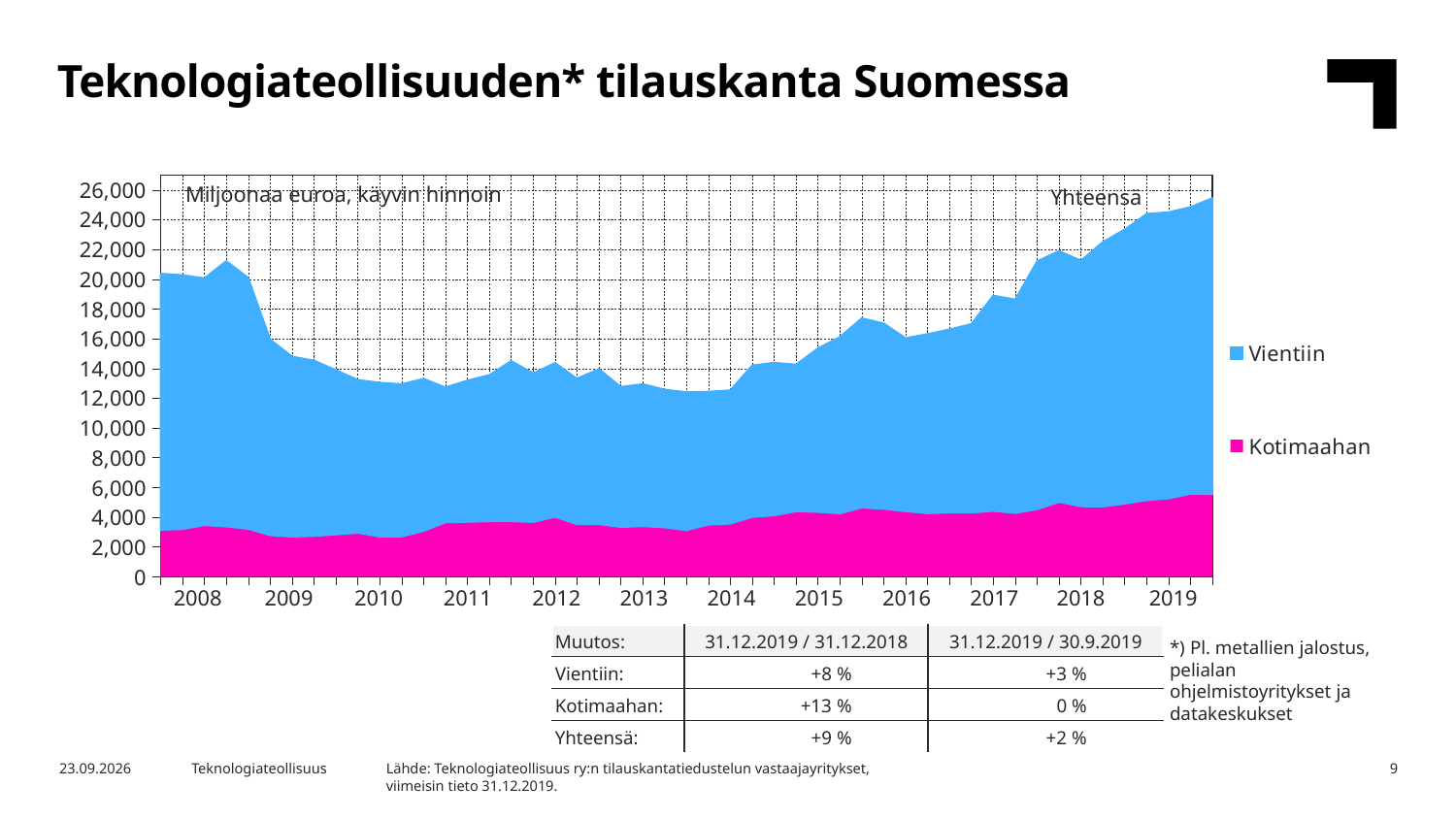
Does the total order book rise or fall from 2014 to 2019? Rises Is the total order book larger in 2019 or in 2013? 2019 How many series does the legend list? 2 Is the total (Yhteensä) value during 2013 greater or less than 14,000? less Is the total (Yhteensä) value at the end of 2019 greater or less than 24,000? greater What kind of chart is shown on the slide? Stacked area chart How many year labels are shown on the x axis? 12 What are the two series named in the legend? Vientiin and Kotimaahan Which series accounts for the larger part of the order book, Vientiin or Kotimaahan? Vientiin Is the Kotimaahan value at the end of 2019 greater or less than 4,000? greater What unit label is printed inside the chart area at the top left? Miljoonaa euroa, käyvin hinnoin